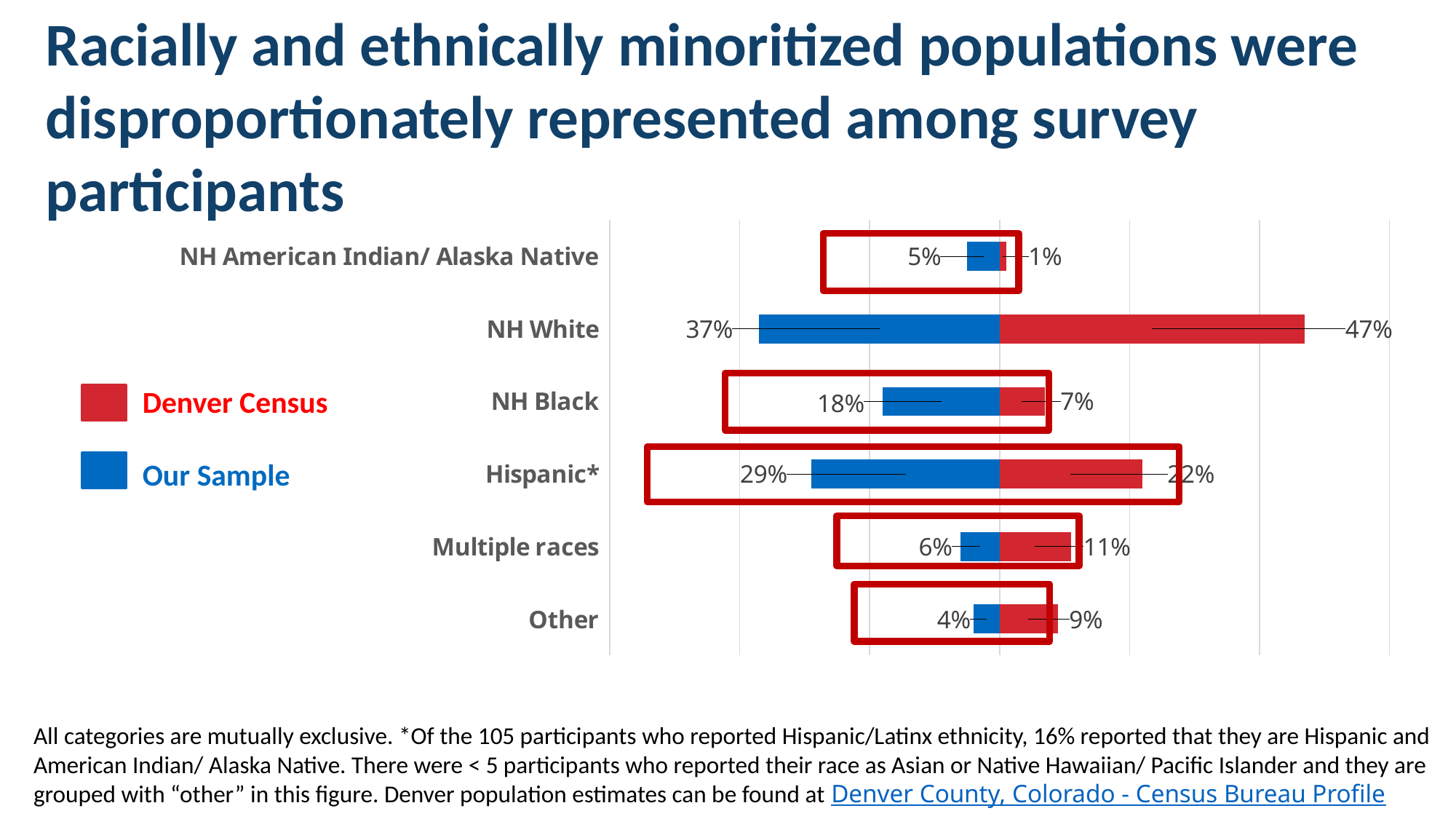
What is the Denver Census value for NH White? 47% What is the difference between the Our Sample and Denver Census values for NH Black? 11% What is the Denver Census value for Hispanic*? 22% Which category has the lowest Denver Census value? NH American Indian/ Alaska Native What is the difference between the Denver Census and Our Sample values for NH White? 10% For Multiple races, which is larger: the Denver Census value or the Our Sample value? Denver Census Which category has the highest Our Sample value? NH White What kind of chart is shown on the slide? Bar chart How many series does the legend list? 2 What is the Our Sample value for Other? 4% What is the Our Sample value for NH Black? 18% How many race/ethnicity categories are shown in the chart? 6